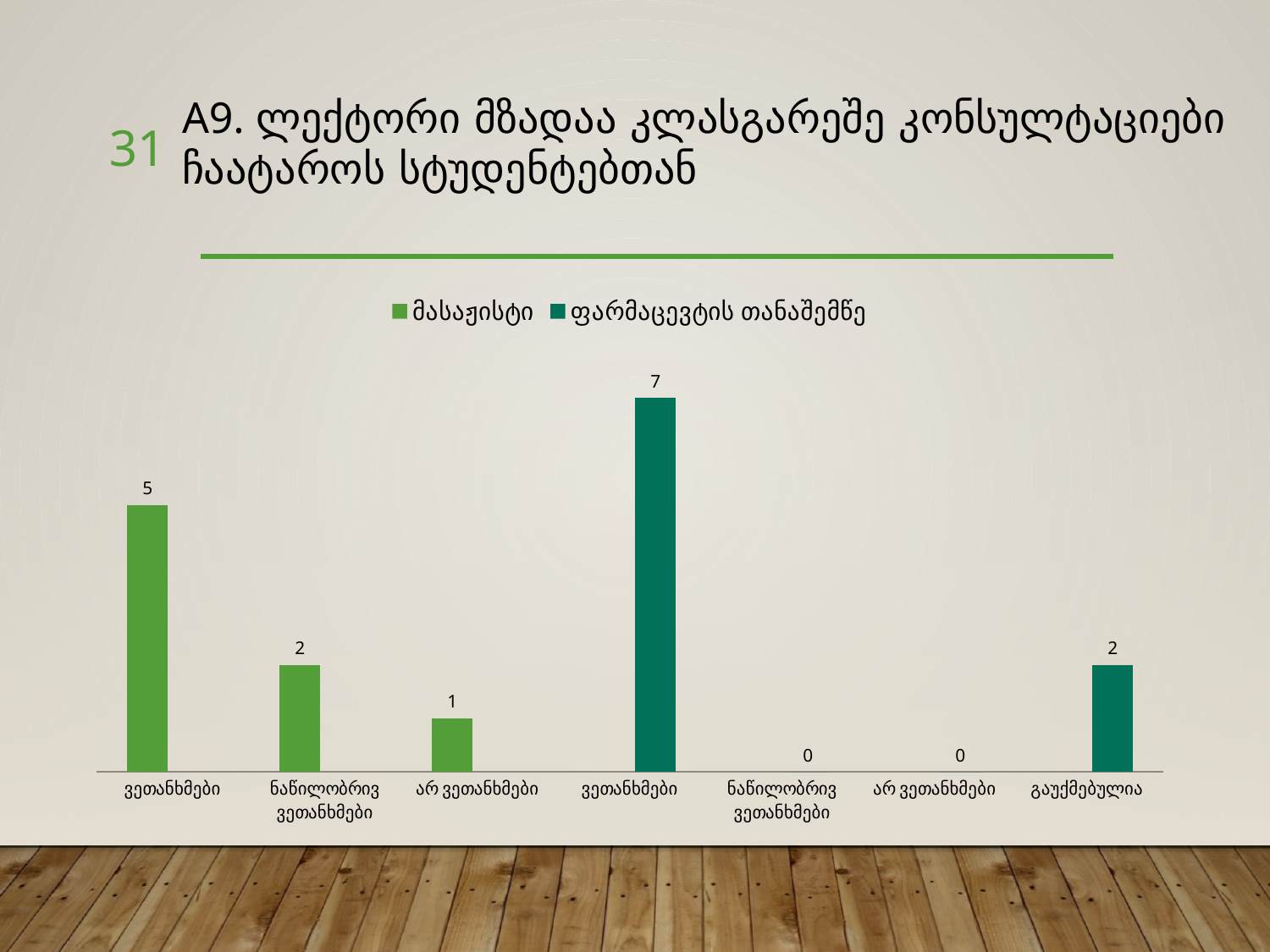
What is the value of the ვეთანხმები bar for the ფარმაცევტის თანაშემწე series? 7 Which bar has the highest value on the chart? ვეთანხმები (ფარმაცევტის თანაშემწე) What is the total of the three მასაჟისტი bars? 8 How many bars on the chart have a value of 0? 2 What is the value of the არ ვეთანხმები bar for the მასაჟისტი series? 1 How many series does the legend list? 2 What is the value of the ვეთანხმები bar for the მასაჟისტი series? 5 What kind of chart is shown on the slide? bar chart What is the difference between the ვეთანხმები values of the ფარმაცევტის თანაშემწე series and the მასაჟისტი series? 2 Which is larger: the ნაწილობრივ ვეთანხმები value for მასაჟისტი or for ფარმაცევტის თანაშემწე? მასაჟისტი What are the two series named in the legend? მასაჟისტი and ფარმაცევტის თანაშემწე What is the value of the გაუქმებულია bar? 2